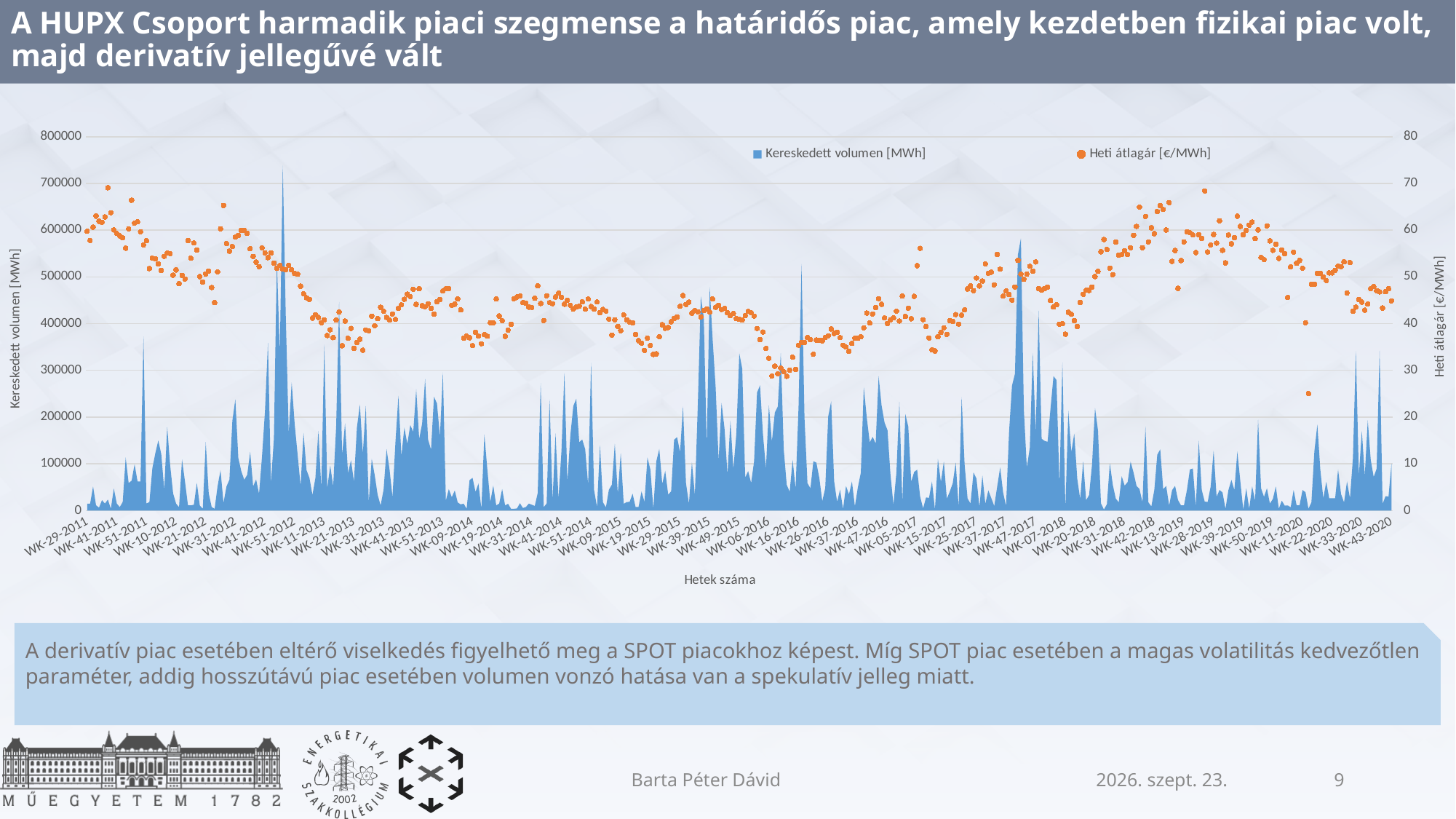
What is the title of the x axis of the chart? Hetek száma How many series does the chart legend list? 2 Is the highest peak of the traded volume (Kereskedett volumen) greater or less than 600000? greater Is the highest weekly average price (Heti átlagár) on the chart greater or less than 60? greater Is the lowest weekly average price (Heti átlagár) on the chart greater or less than 30? less What are the two series named in the chart legend? Kereskedett volumen [MWh] and Heti átlagár [€/MWh] Which series is plotted against the right-hand axis, the traded volume or the weekly average price? Heti átlagár [€/MWh] (weekly average price) What kind of chart is shown on the slide? Combination chart: an area series with a scatter (dot) series Does the weekly average price (Heti átlagár) rise or fall between WK-29-2011 and WK-21-2013? fall Does the weekly average price (Heti átlagár) rise or fall between WK-06-2016 and WK-37-2017? rise